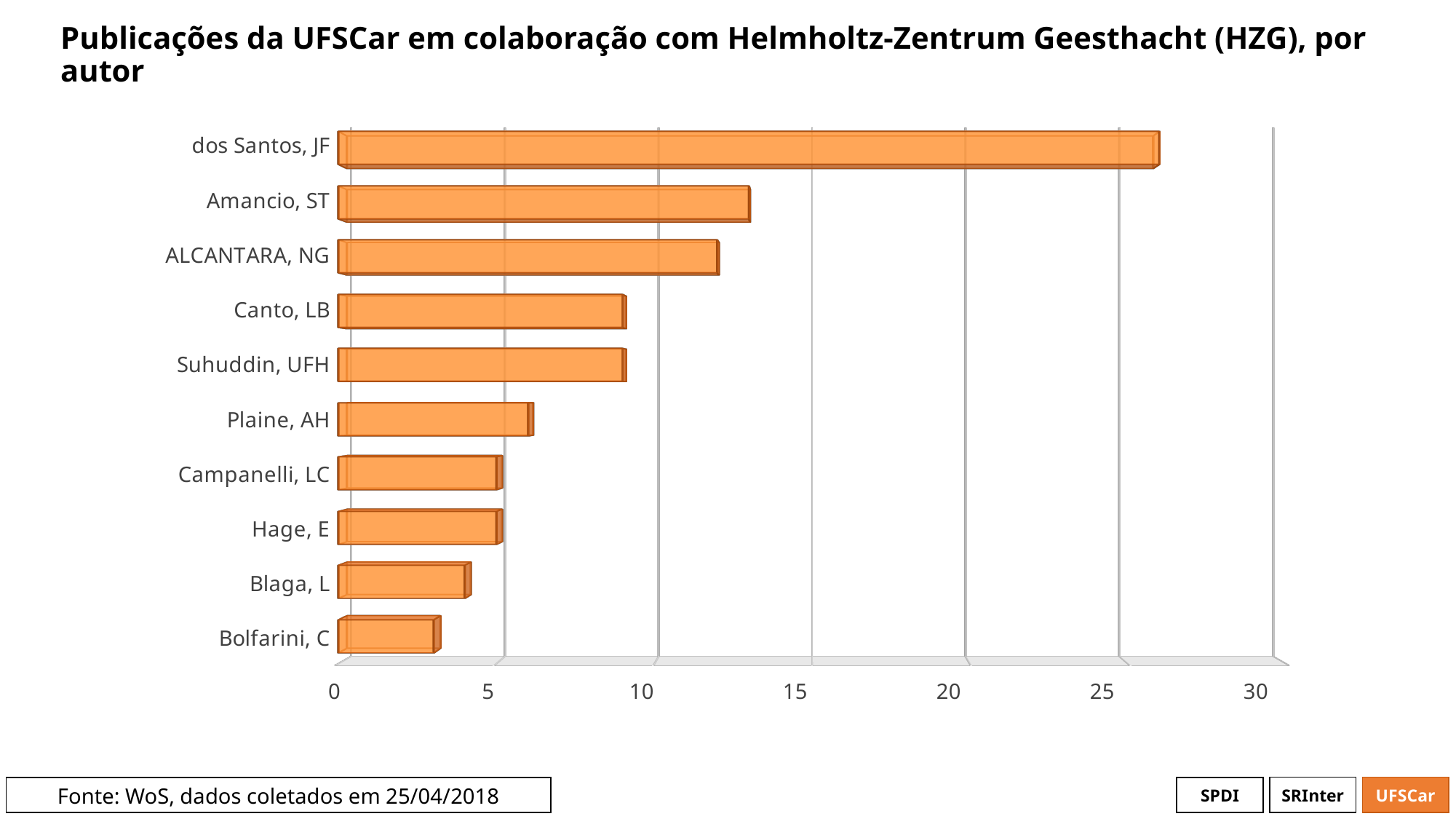
What kind of chart is shown on the slide? bar chart Who has more publications, Plaine, AH or Blaga, L? Plaine, AH What is the title of the chart? Publicações da UFSCar em colaboração com Helmholtz-Zentrum Geesthacht (HZG), por autor Is the value for Plaine, AH greater or less than 5? greater Which author has the lowest number of publications? Bolfarini, C Is the value for Canto, LB greater or less than 10? less Is the value for Bolfarini, C greater or less than 5? less Who has more publications, Amancio, ST or ALCANTARA, NG? Amancio, ST Which author has the highest number of publications? dos Santos, JF How many authors are listed on the chart? 10